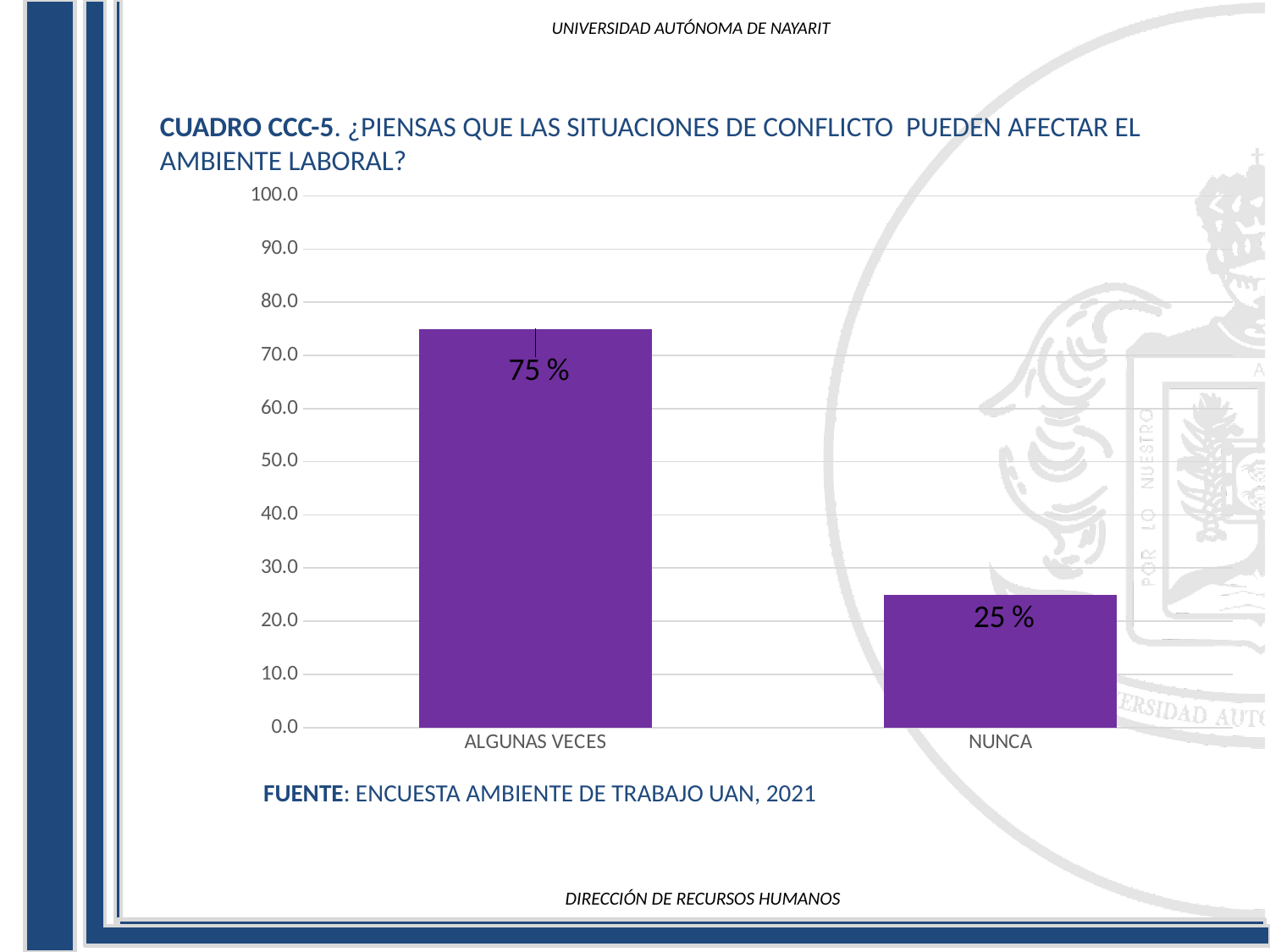
What kind of chart is shown on the slide? bar chart Is the value for ALGUNAS VECES greater or less than 70.0? greater Which is larger, the value for ALGUNAS VECES or the value for NUNCA? ALGUNAS VECES What is the value for ALGUNAS VECES? 75 % What is the value for NUNCA? 25 % How many categories are shown on the x axis? 2 Which category has the highest value? ALGUNAS VECES What is the maximum value shown on the y axis? 100.0 Is the value for NUNCA greater or less than 30.0? less What is the difference between the values for ALGUNAS VECES and NUNCA? 50 % Which category has the lowest value? NUNCA What is the source cited below the chart? ENCUESTA AMBIENTE DE TRABAJO UAN, 2021